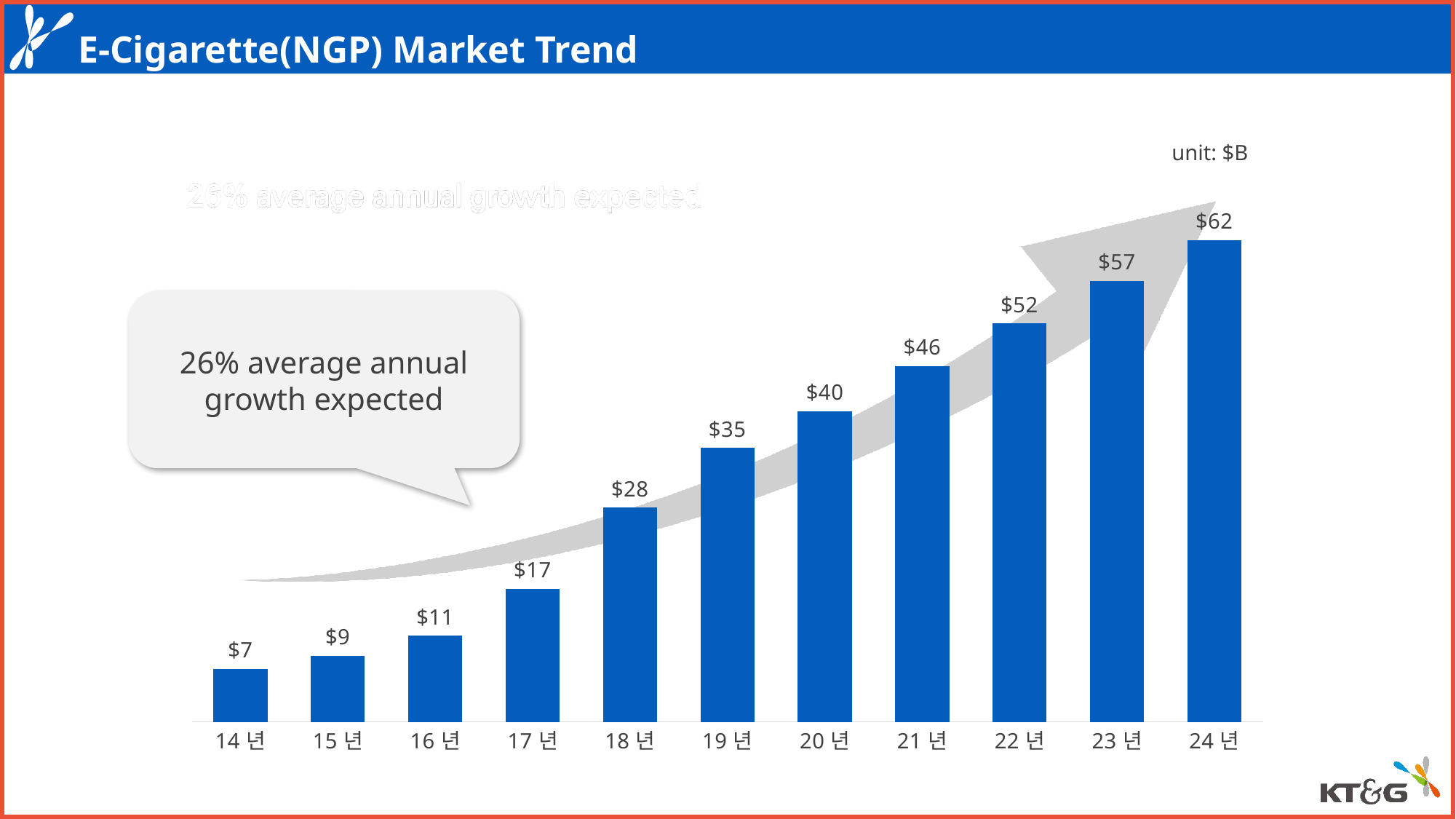
What is the difference between the values for 24 년 and 23 년? $5 Which year has the highest value? 24 년 Which year has the lowest value? 14 년 What is the value for 21 년? $46 What kind of chart is shown on the slide? bar chart Do the values rise or fall from 14 년 to 24 년? rise What unit is stated for the chart values? $B How many years are shown on the x axis? 11 What is the difference between the values for 20 년 and 16 년? $29 Which is larger, the value for 19 년 or the value for 17 년? 19 년 What is the value for 18 년? $28 What is the value for 14 년? $7